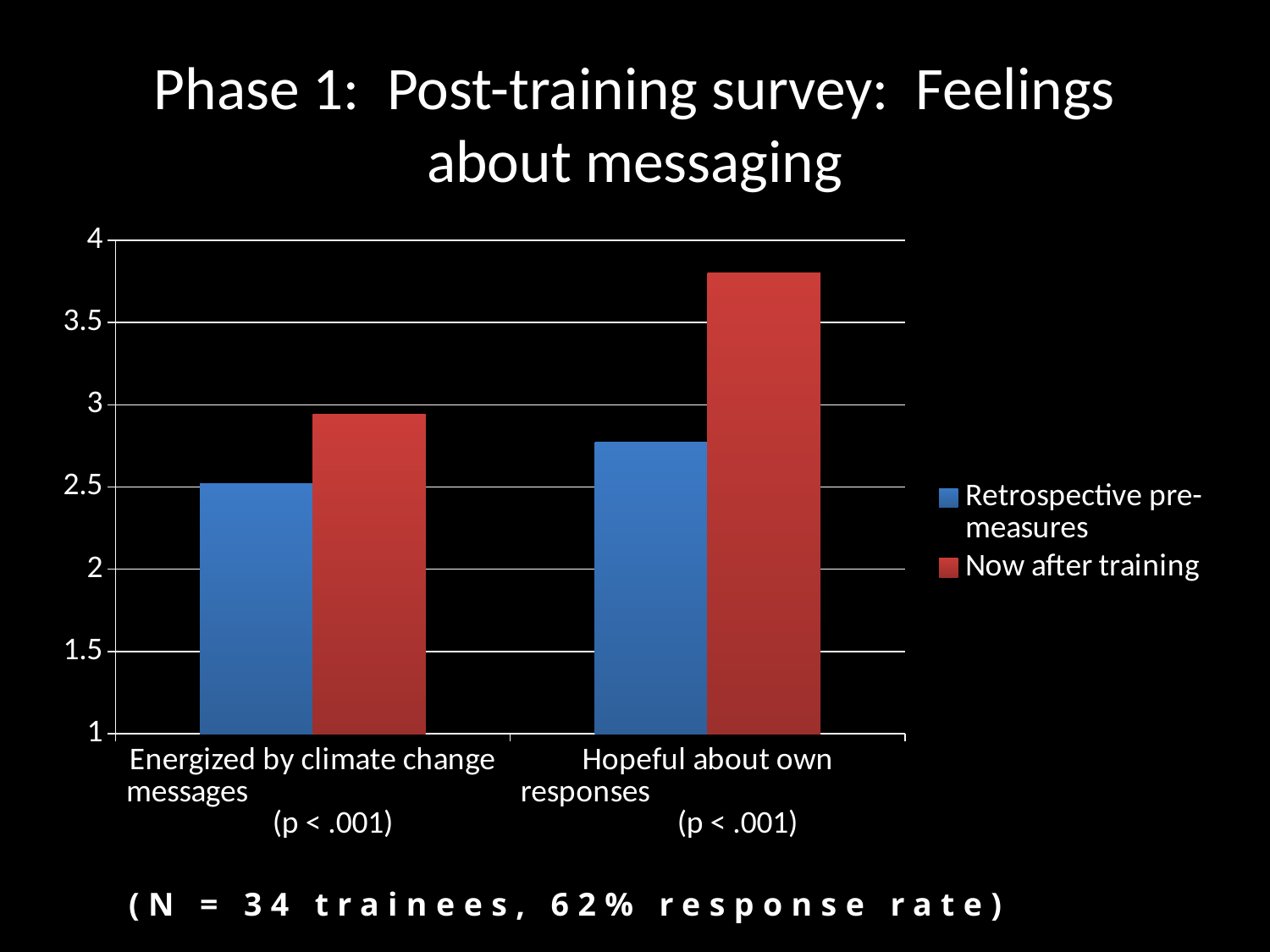
Which colour represents the 'Now after training' series? red How many categories are shown on the x axis? 2 Is the 'Now after training' value for 'Energized by climate change messages' greater or less than 3? less Which category has the lowest 'Retrospective pre-measures' value? Energized by climate change messages What is the title of the chart on the slide? Phase 1: Post-training survey: Feelings about messaging What kind of chart is shown on the slide? bar chart Which series has the tallest bar in the chart? Now after training Is the 'Retrospective pre-measures' value for 'Hopeful about own responses' greater or less than 2.5? greater For 'Energized by climate change messages', which is larger: the 'Retrospective pre-measures' value or the 'Now after training' value? Now after training Which category has the highest 'Now after training' value? Hopeful about own responses Is the 'Now after training' value for 'Hopeful about own responses' greater or less than 3.5? greater How many series does the legend list? 2